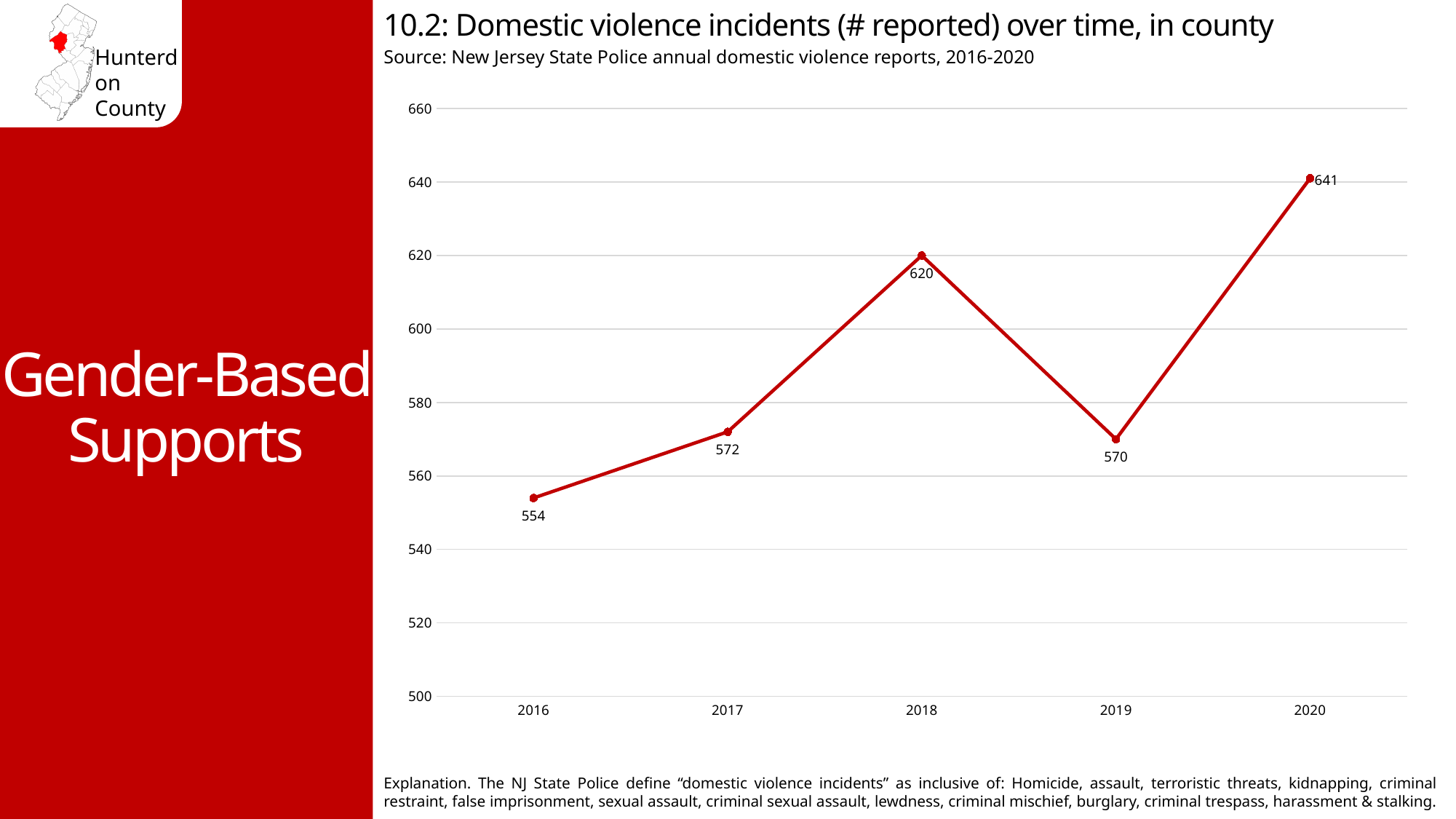
How many reported domestic violence incidents were there in 2018? 620 Which year had the highest number of reported domestic violence incidents? 2020 How many reported domestic violence incidents were there in 2016? 554 What type of chart is shown on the slide? line chart Which year had more reported incidents, 2017 or 2019? 2017 Did the number of reported incidents rise or fall from 2018 to 2019? fall Which year had the lowest number of reported domestic violence incidents? 2016 What is the difference in reported incidents between 2020 and 2019? 71 How many reported domestic violence incidents were there in 2020? 641 What is the difference in reported incidents between 2018 and 2017? 48 What is the source cited for the chart data? New Jersey State Police annual domestic violence reports, 2016-2020 How many years are plotted on the chart? 5